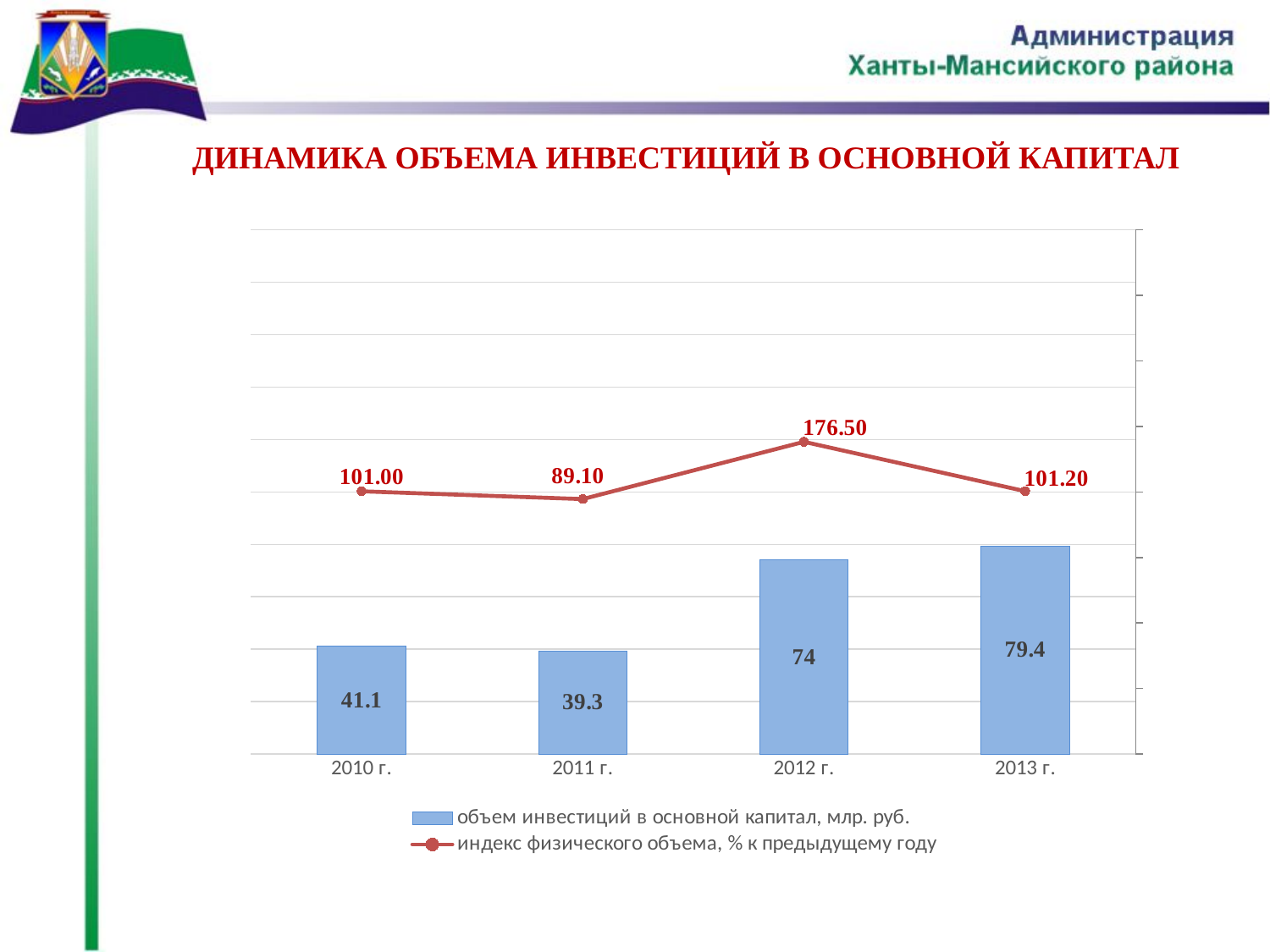
Does объем инвестиций в основной капитал rise or fall from 2011 г. to 2013 г.? Rise How many years are shown on the x axis? 4 What kinds of chart are combined on this slide? Bar chart and line chart What is the value of объем инвестиций в основной капитал for 2012 г.? 74 What is the difference between индекс физического объема in 2012 г. and 2013 г.? 75.30 How many series does the legend list? 2 In which year is объем инвестиций в основной капитал lowest? 2011 г. What is the value of объем инвестиций в основной капитал for 2010 г.? 41.1 Which year has the larger индекс физического объема, 2010 г. or 2011 г.? 2010 г. What is the difference between объем инвестиций в основной капитал in 2013 г. and 2012 г.? 5.4 What is the value of индекс физического объема for 2011 г.? 89.10 In which year is индекс физического объема highest? 2012 г.